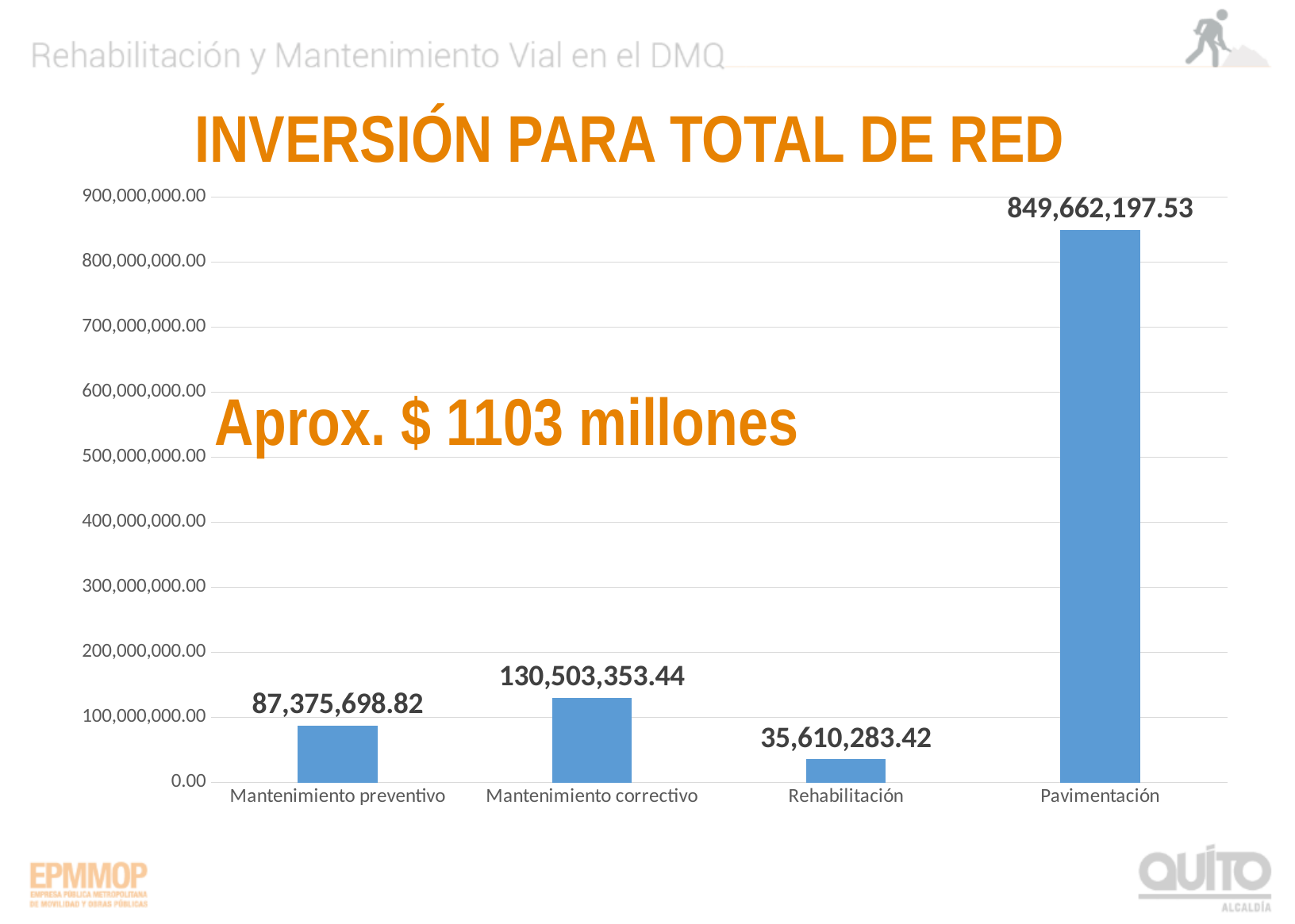
Which category has the lowest value? Rehabilitación Which category has the highest value? Pavimentación What is the title of the chart? INVERSIÓN PARA TOTAL DE RED What is the difference between the values for Pavimentación and Rehabilitación? 814,051,914.11 What is the value for Mantenimiento preventivo? 87,375,698.82 How many categories are shown on the x axis? 4 What is the value for Pavimentación? 849,662,197.53 Is the value for Pavimentación greater or less than 800,000,000.00? greater What is the value for Rehabilitación? 35,610,283.42 Which is larger, the value for Mantenimiento preventivo or the value for Rehabilitación? Mantenimiento preventivo What is the difference between the values for Mantenimiento correctivo and Mantenimiento preventivo? 43,127,654.62 What is the value for Mantenimiento correctivo? 130,503,353.44